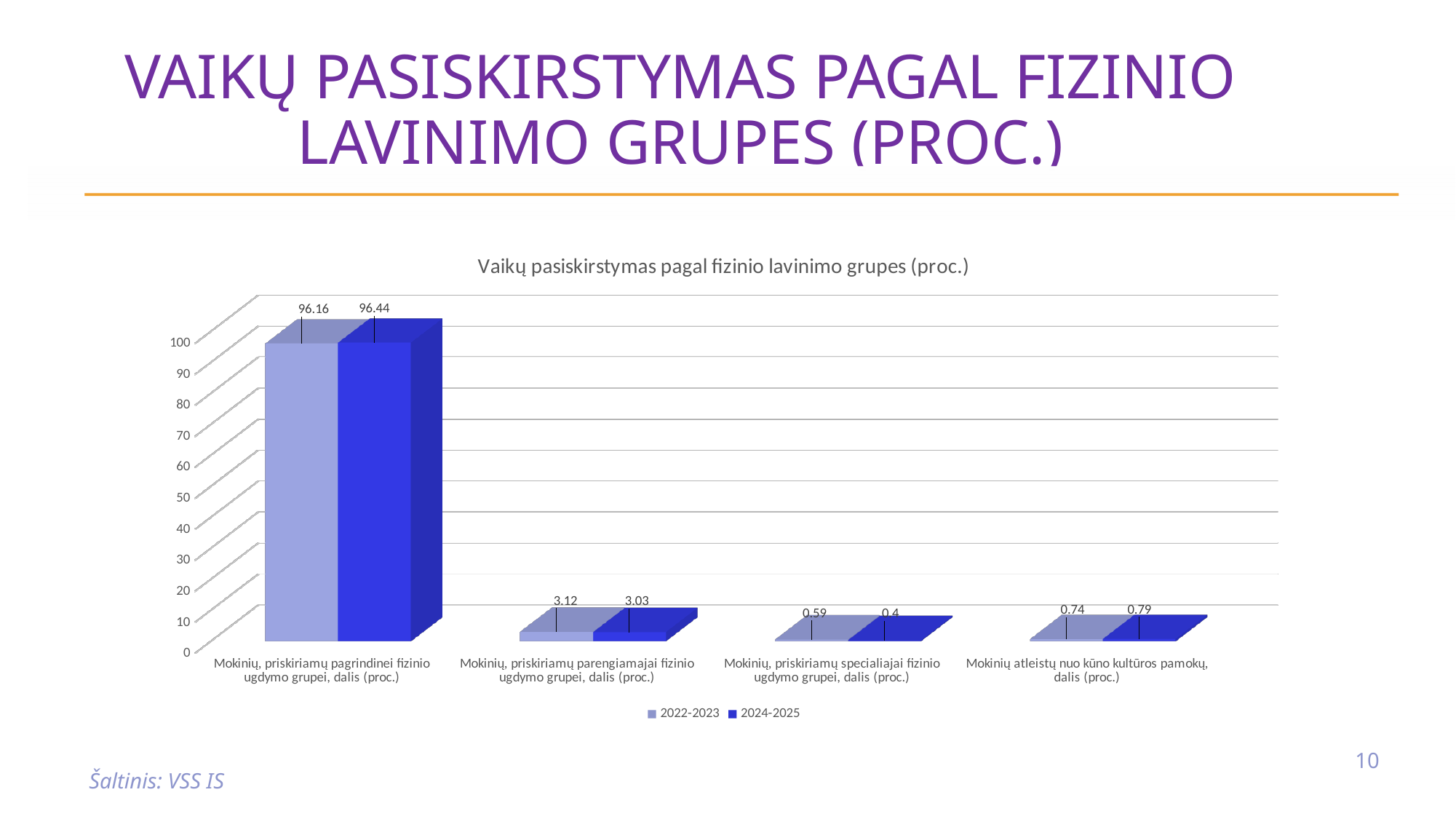
What is the 2022-2023 value for 'Mokinių atleistų nuo kūno kultūros pamokų, dalis (proc.)'? 0.74 How many series does the chart legend list? 2 What is the difference between the 2024-2025 and 2022-2023 values for 'Mokinių, priskiriamų pagrindinei fizinio ugdymo grupei, dalis (proc.)'? 0.28 What type of chart is shown on the slide? Bar chart What is the 2024-2025 value for 'Mokinių, priskiriamų specialiajai fizinio ugdymo grupei, dalis (proc.)'? 0.4 How many categories are shown on the x axis of the chart? 4 Which category has the highest value in the 2024-2025 series? Mokinių, priskiriamų pagrindinei fizinio ugdymo grupei, dalis (proc.) What is the 2024-2025 value for 'Mokinių, priskiriamų parengiamajai fizinio ugdymo grupei, dalis (proc.)'? 3.03 For 'Mokinių atleistų nuo kūno kultūros pamokų, dalis (proc.)', which series has the larger value, 2022-2023 or 2024-2025? 2024-2025 What is the 2022-2023 value for 'Mokinių, priskiriamų pagrindinei fizinio ugdymo grupei, dalis (proc.)'? 96.16 What is the title of the chart? Vaikų pasiskirstymas pagal fizinio lavinimo grupes (proc.) Which category has the lowest value in the 2022-2023 series? Mokinių, priskiriamų specialiajai fizinio ugdymo grupei, dalis (proc.)